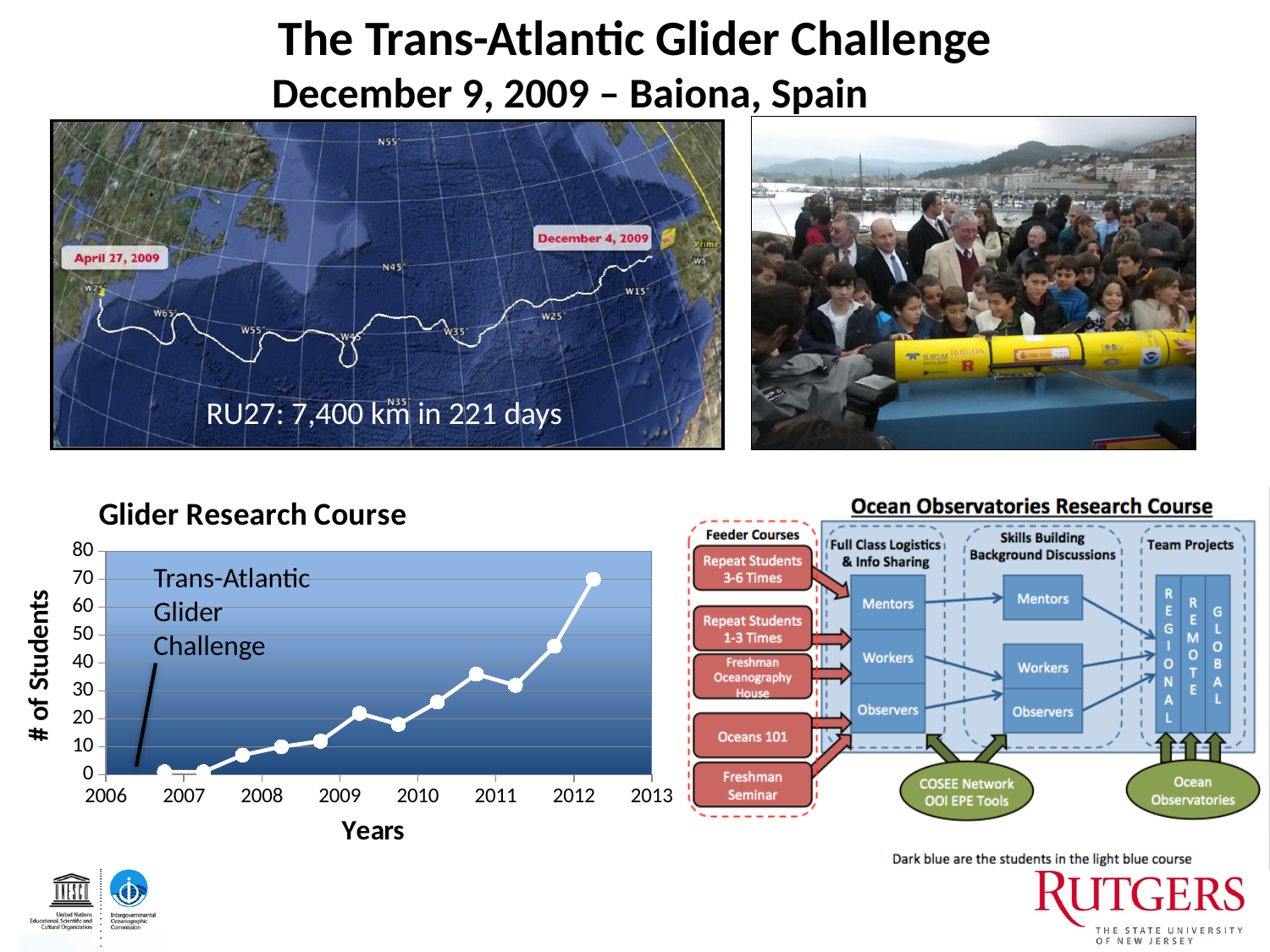
On the Glider Research Course chart, which is larger: the number of students near 2012 or near 2011? 2012 What kind of chart is the Glider Research Course chart? line chart Overall, do the values on the Glider Research Course chart rise or fall from 2006 to 2013? rise Is the highest value on the Glider Research Course chart greater or less than 60? greater What is the highest tick value shown on the y-axis of the Glider Research Course chart? 80 What is the title of the chart on the slide? Glider Research Course Is the value for the point just before 2011 on the Glider Research Course chart greater or less than 30? greater Around which year does the Glider Research Course chart show its lowest number of students? 2007 How many year labels are shown on the x-axis of the Glider Research Course chart? 8 Around which year does the Glider Research Course chart reach its highest number of students? 2012 What is the label of the y-axis on the Glider Research Course chart? # of Students